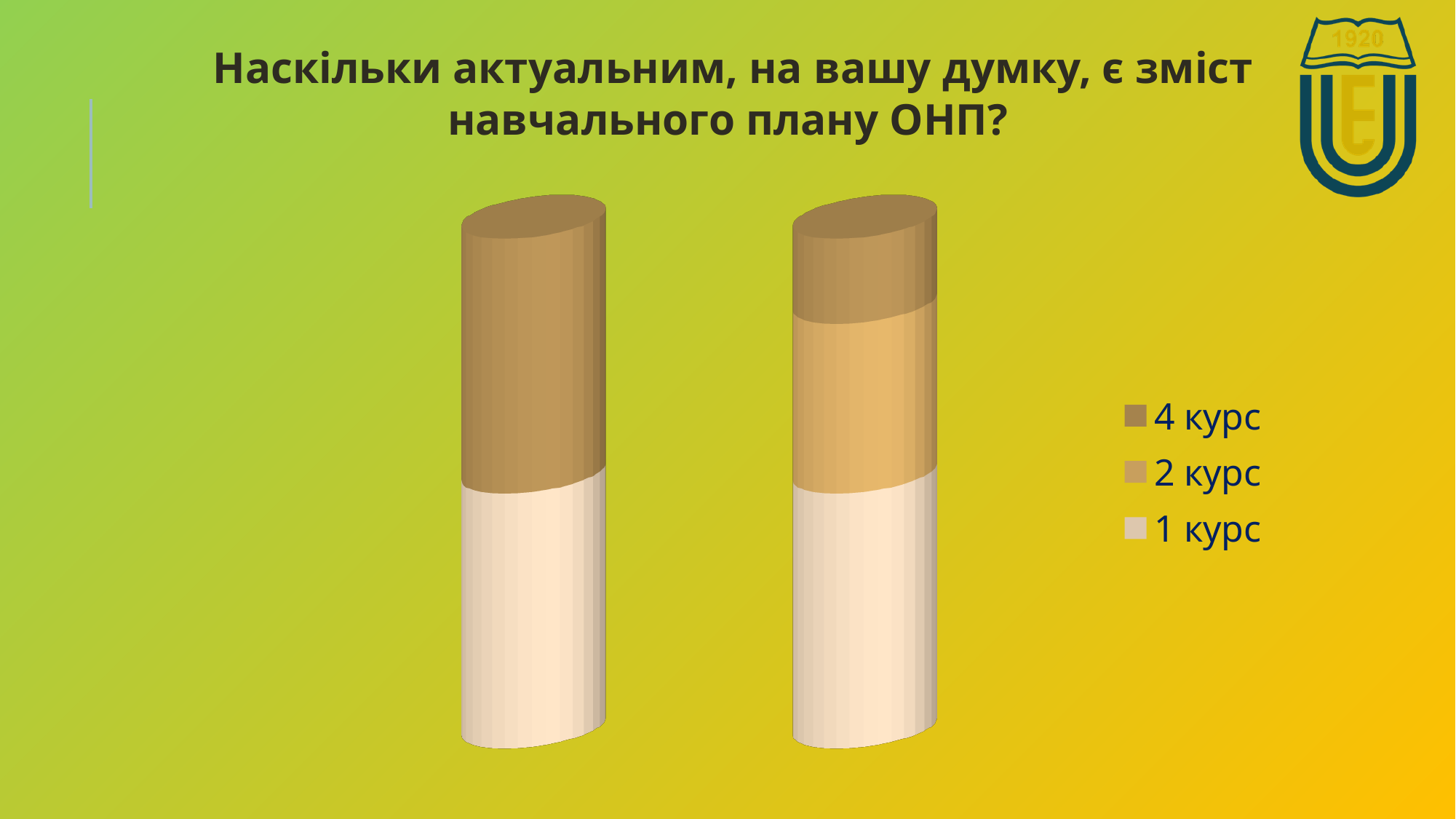
How many series does the legend list? 3 What is the title of the chart? Наскільки актуальним, на вашу думку, є зміст навчального плану ОНП? In the right bar, which series has the smallest segment? 4 курс In the right bar, is the 2 курс segment larger or smaller than the 4 курс segment? larger What kind of chart is shown on the slide? bar chart In the right bar, is the 1 курс segment larger or smaller than the 2 курс segment? larger What are the legend entries of the chart? 4 курс, 2 курс, 1 курс In the right bar, which series has the largest segment? 1 курс How many bars are plotted in the chart? 2 How many segments does the left bar contain? 2